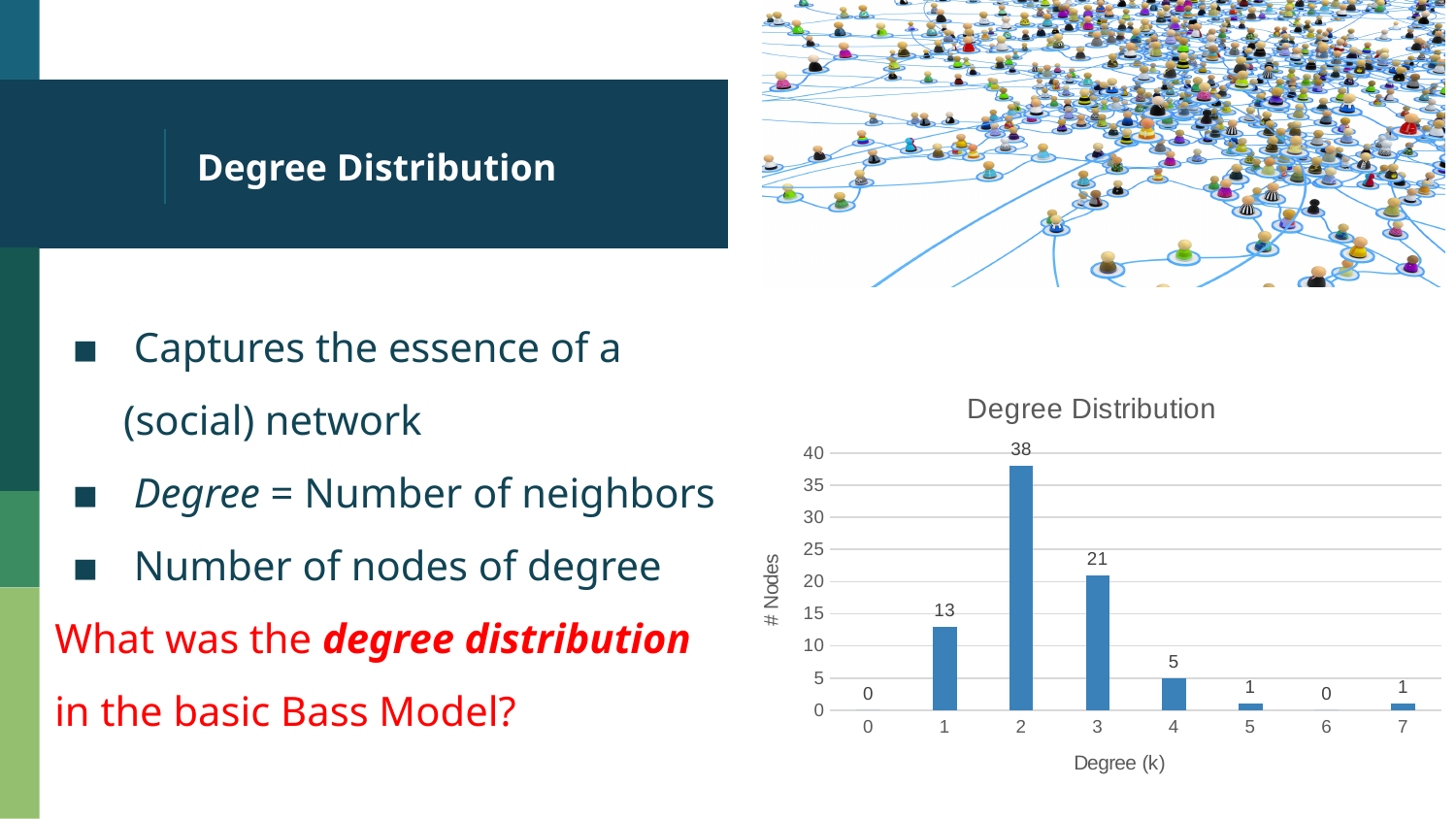
What is the number of nodes with degree 2? 38 Is the number of nodes with degree 2 greater or less than 35? greater What is the number of nodes with degree 1? 13 What kind of chart is shown? Bar chart How many degree categories are shown on the x axis? 8 Which degree (k) has the highest number of nodes? 2 What is the number of nodes with degree 4? 5 What is the title of the chart? Degree Distribution What is the difference in number of nodes between degree 2 and degree 3? 17 What is the number of nodes with degree 3? 21 What is the label of the y axis? # Nodes Which has more nodes, degree 1 or degree 4? Degree 1